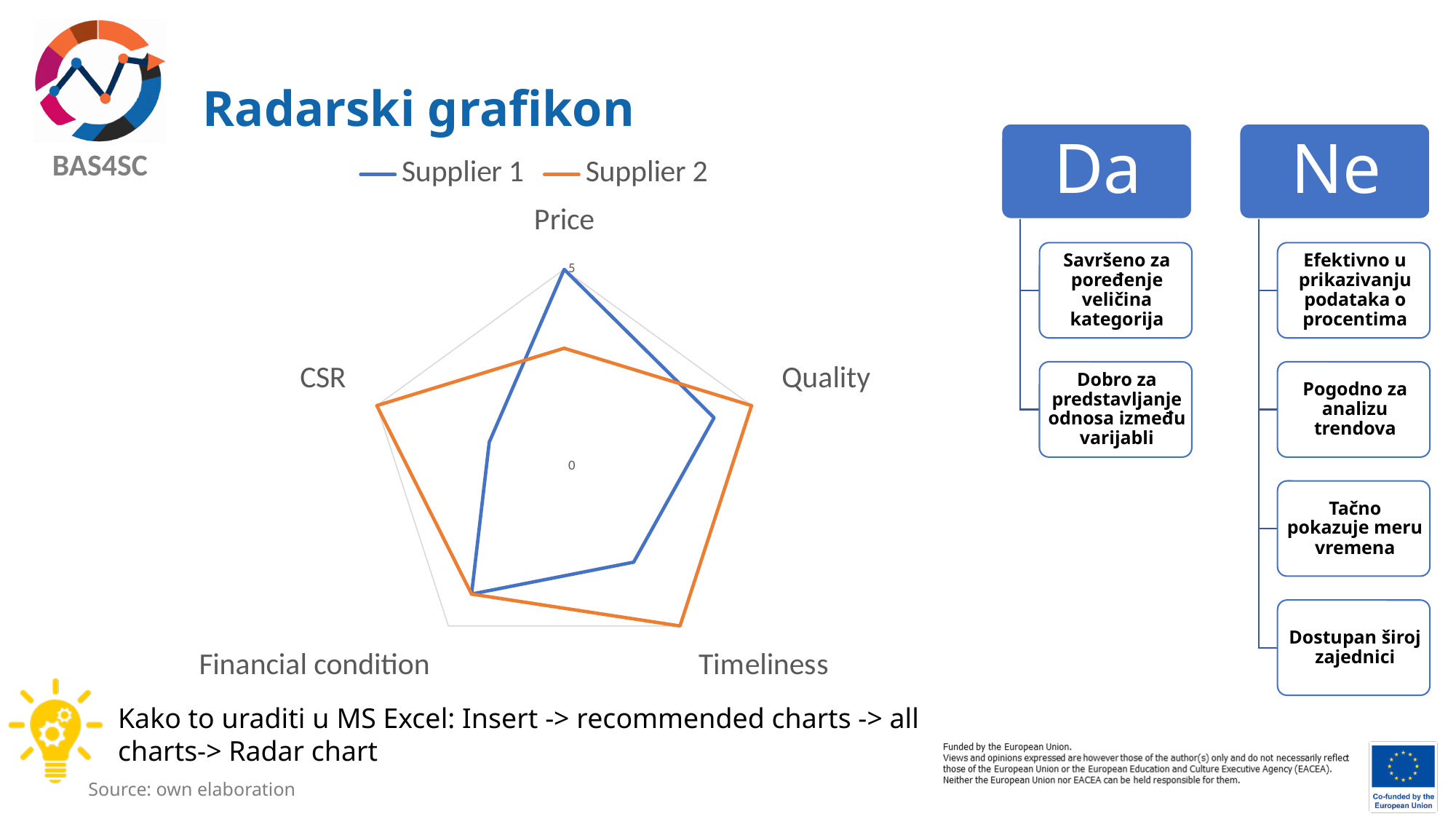
What is the value for Supplier 1 on the Price axis? 5 Which supplier has the larger value for Timeliness? Supplier 2 What is the value for Supplier 2 on the Quality axis? 5 What kind of chart is shown on the slide? Radar chart What is the value for Supplier 2 on the CSR axis? 5 Which supplier has the larger value for CSR? Supplier 2 Which colour represents Supplier 2 in the legend? Orange On which axis does Supplier 2 have its lowest value? Price Which supplier has the larger value for Price? Supplier 1 On which axis does Supplier 1 reach its highest value? Price How many categories (axes) does the radar chart have? 5 How many series does the chart legend list? 2